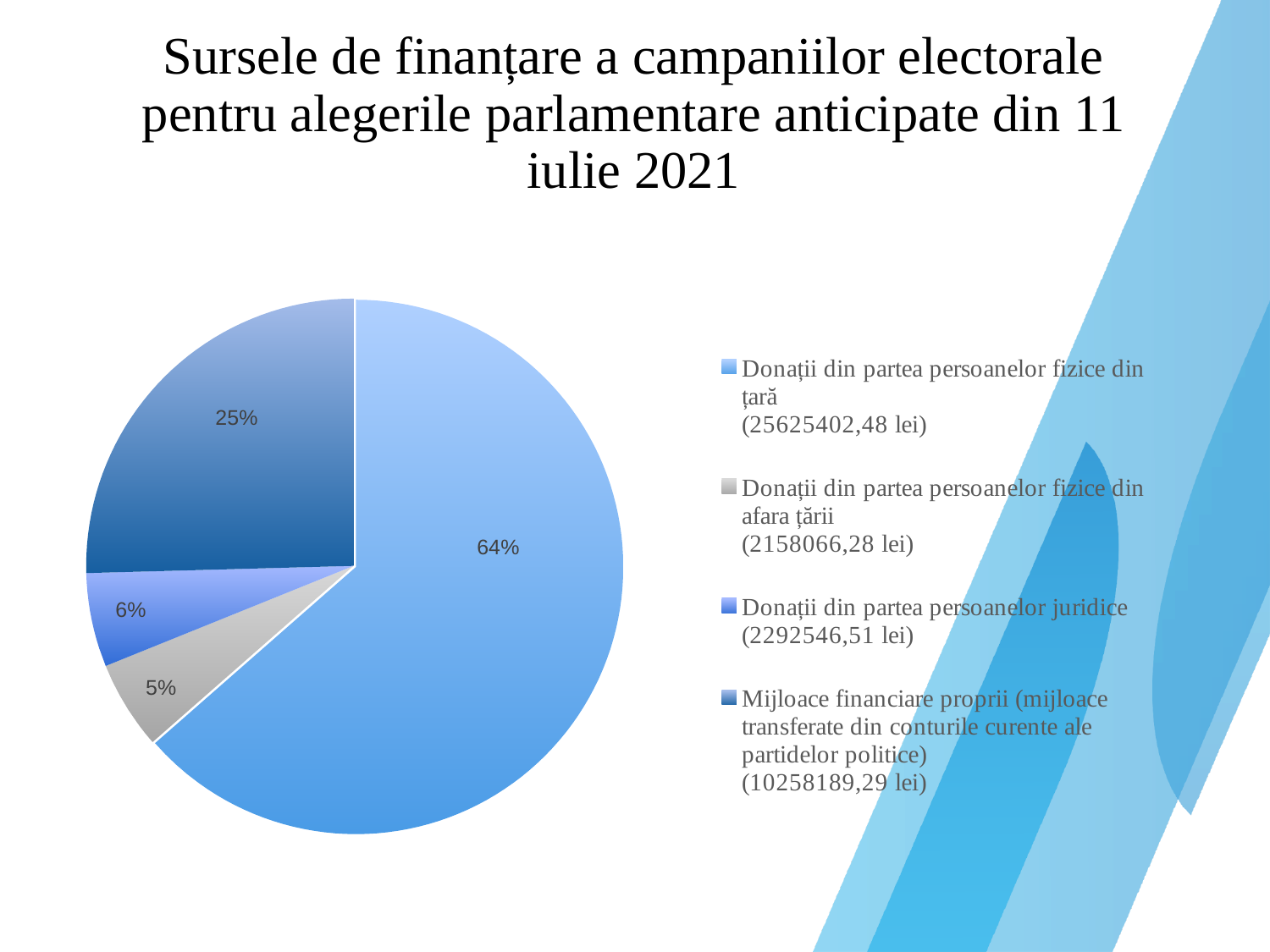
Which funding source has the smallest share of the pie? Donații din partea persoanelor fizice din afara țării Which funding source has the largest share of the pie? Donații din partea persoanelor fizice din țară What share of the pie is 'Donații din partea persoanelor juridice'? 6% What is the difference in percentage points between the share for 'Donații din partea persoanelor fizice din țară' and the share for 'Mijloace financiare proprii'? 39 How many slices does the pie chart have? 4 What share of the pie is 'Mijloace financiare proprii (mijloace transferate din conturile curente ale partidelor politice)'? 25% Which is larger: the share for 'Donații din partea persoanelor juridice' or the share for 'Donații din partea persoanelor fizice din afara țării'? Donații din partea persoanelor juridice What kind of chart is shown on the slide? pie chart What share of the pie is 'Donații din partea persoanelor fizice din țară'? 64% What is the title of the slide containing the pie chart? Sursele de finanțare a campaniilor electorale pentru alegerile parlamentare anticipate din 11 iulie 2021 According to the legend, what amount in lei corresponds to 'Donații din partea persoanelor juridice'? 2292546,51 lei